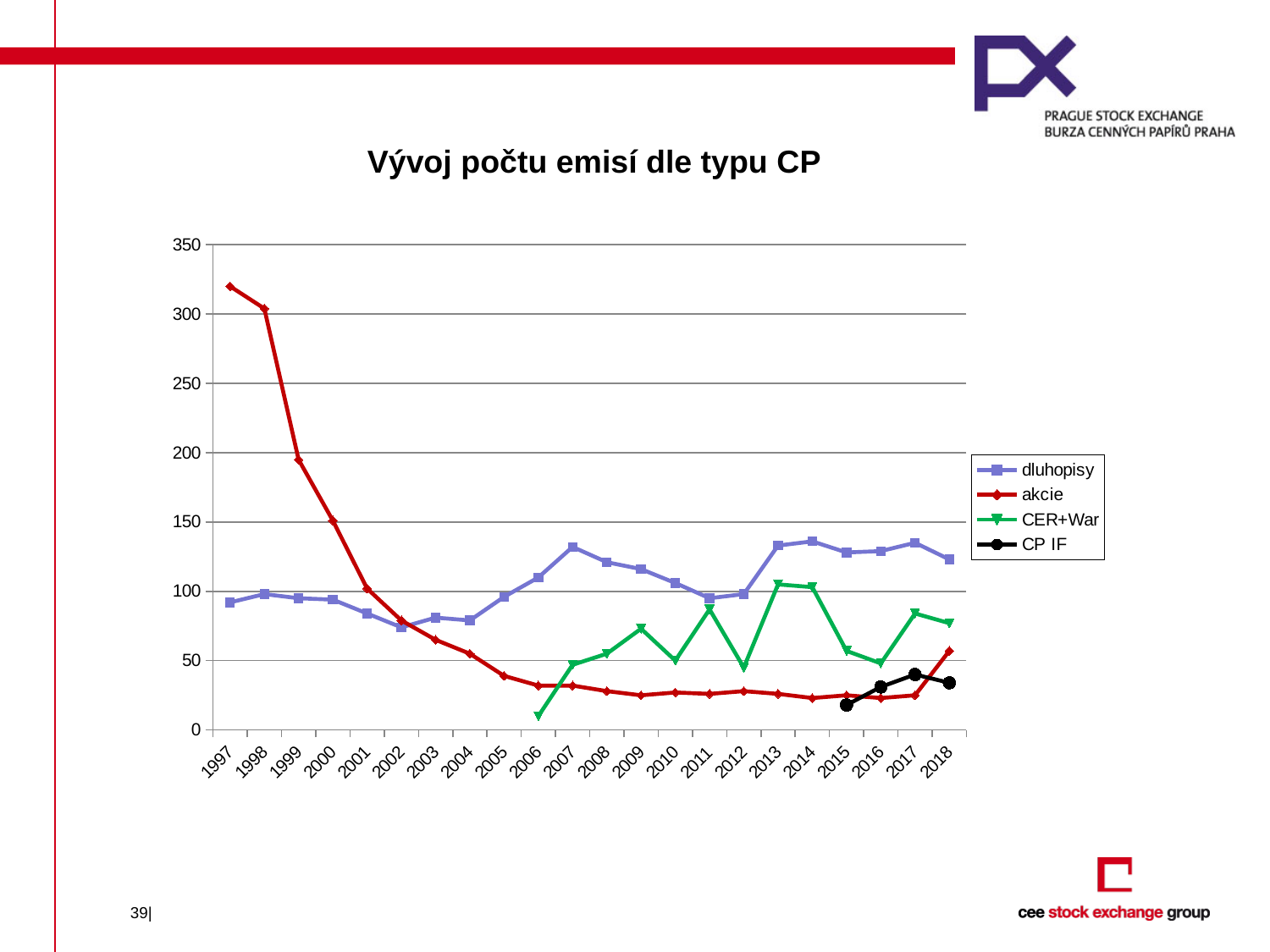
In 2013, which series is larger: CER+War or akcie? CER+War What kind of chart is shown on the slide? line chart Is the value for CP IF in 2015 greater or less than 50? less Is the value for akcie in 1997 greater or less than 300? greater Is the value for CER+War in 2006 greater or less than 50? less How many series does the legend list? 4 In 2018, which series is larger: dluhopisy or akcie? dluhopisy Does the akcie series rise or fall between 1997 and 2006? fall How many years are shown on the x axis? 22 In which year does the CP IF series first appear on the chart? 2015 Which series has the highest value in 1997? akcie